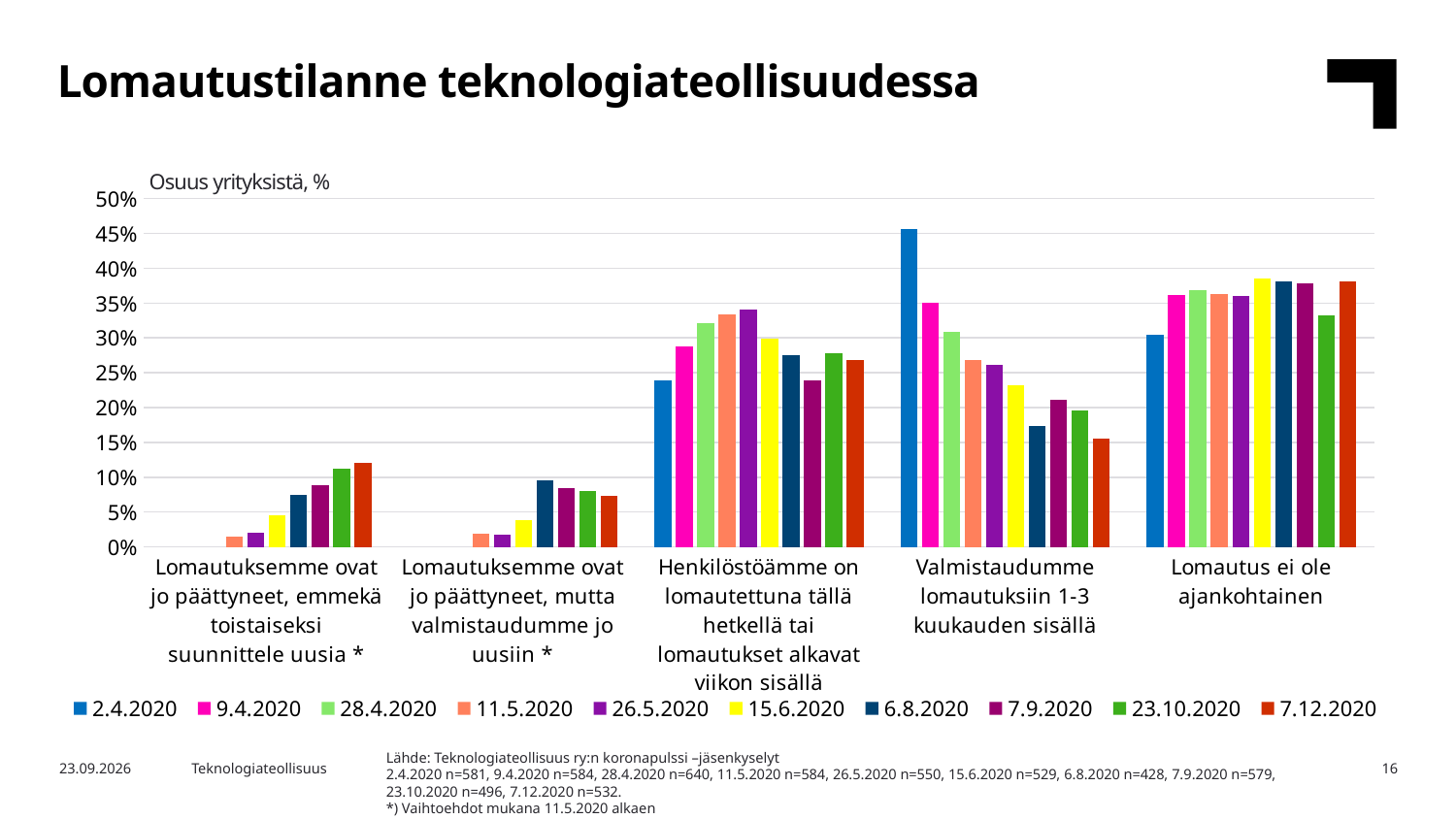
What is the label shown above the y axis of the chart? Osuus yrityksistä, % What kind of chart is shown on the slide? bar chart How many categories are shown on the x axis? 5 For 2.4.2020, which category has the larger value: 'Valmistaudumme lomautuksiin 1-3 kuukauden sisällä' or 'Lomautus ei ole ajankohtainen'? Valmistaudumme lomautuksiin 1-3 kuukauden sisällä Does the value for 'Valmistaudumme lomautuksiin 1-3 kuukauden sisällä' generally rise or fall from 2.4.2020 to 7.12.2020? fall Is the value for 2.4.2020 in the category 'Valmistaudumme lomautuksiin 1-3 kuukauden sisällä' greater or less than 40%? greater How many series (survey dates) does the legend list? 10 Is the value for 7.12.2020 in the category 'Valmistaudumme lomautuksiin 1-3 kuukauden sisällä' greater or less than 20%? less Is the value for 2.4.2020 in the category 'Henkilöstöämme on lomautettuna tällä hetkellä tai lomautukset alkavat viikon sisällä' greater or less than 30%? less Does the value for 'Lomautuksemme ovat jo päättyneet, emmekä toistaiseksi suunnittele uusia *' rise or fall from 11.5.2020 to 7.12.2020? rise Which survey date has the highest value in the category 'Valmistaudumme lomautuksiin 1-3 kuukauden sisällä'? 2.4.2020